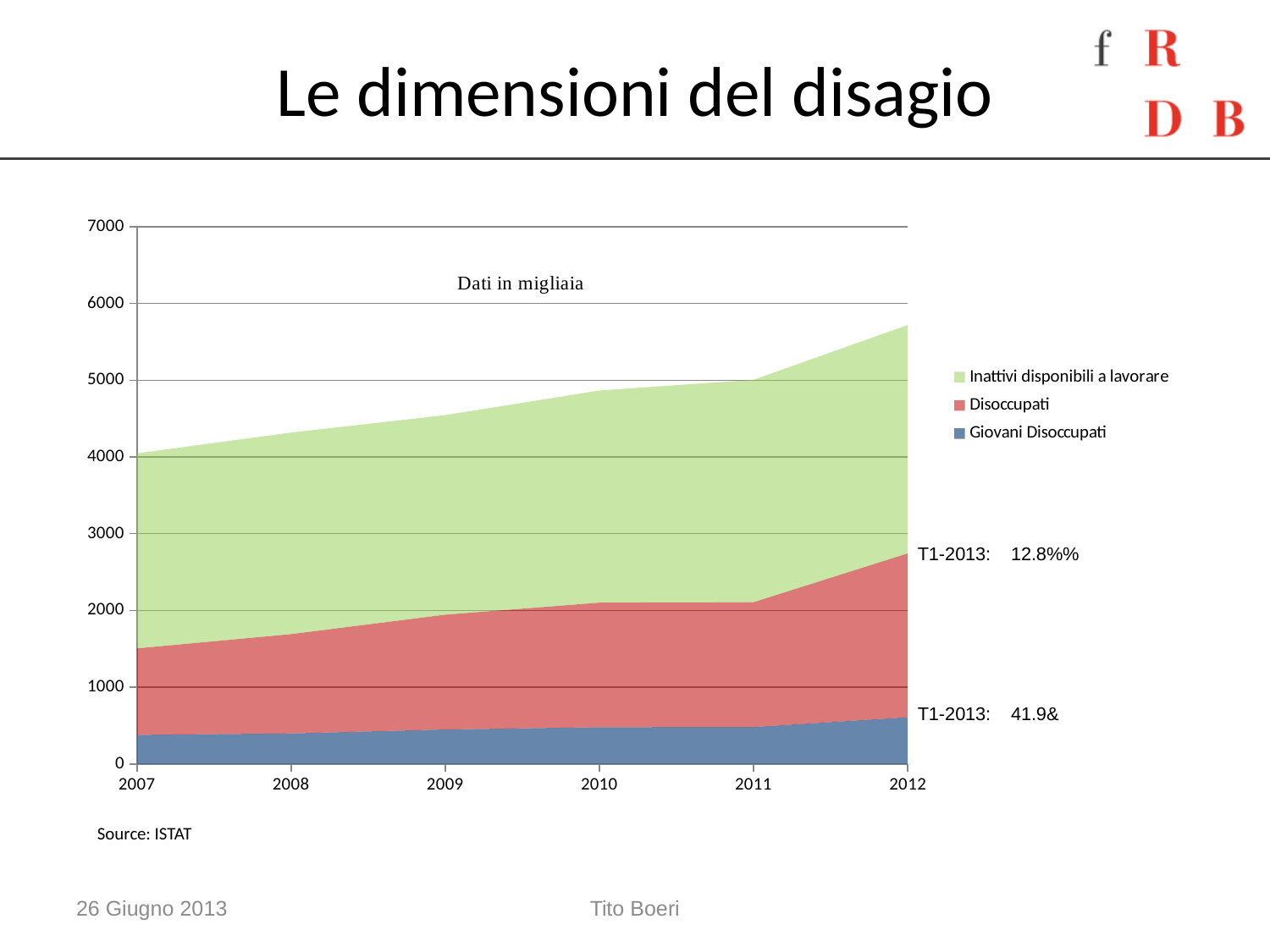
How many years are shown on the x axis of the chart? 6 Is the total of all three series in 2012 greater or less than 5000? greater What kind of chart is shown on the slide? Stacked area chart Is the value for Giovani Disoccupati in 2012 greater or less than 1000? less Does the total of all three series rise or fall from 2007 to 2012? Rise How many series does the chart legend list? 3 Which series is shown at the top of the stacked area chart, according to the legend? Inattivi disponibili a lavorare What unit note is printed inside the chart area? Dati in migliaia What is the last year shown on the x axis? 2012 What is the first year shown on the x axis? 2007 Is the total of all three series in 2007 greater or less than 5000? less